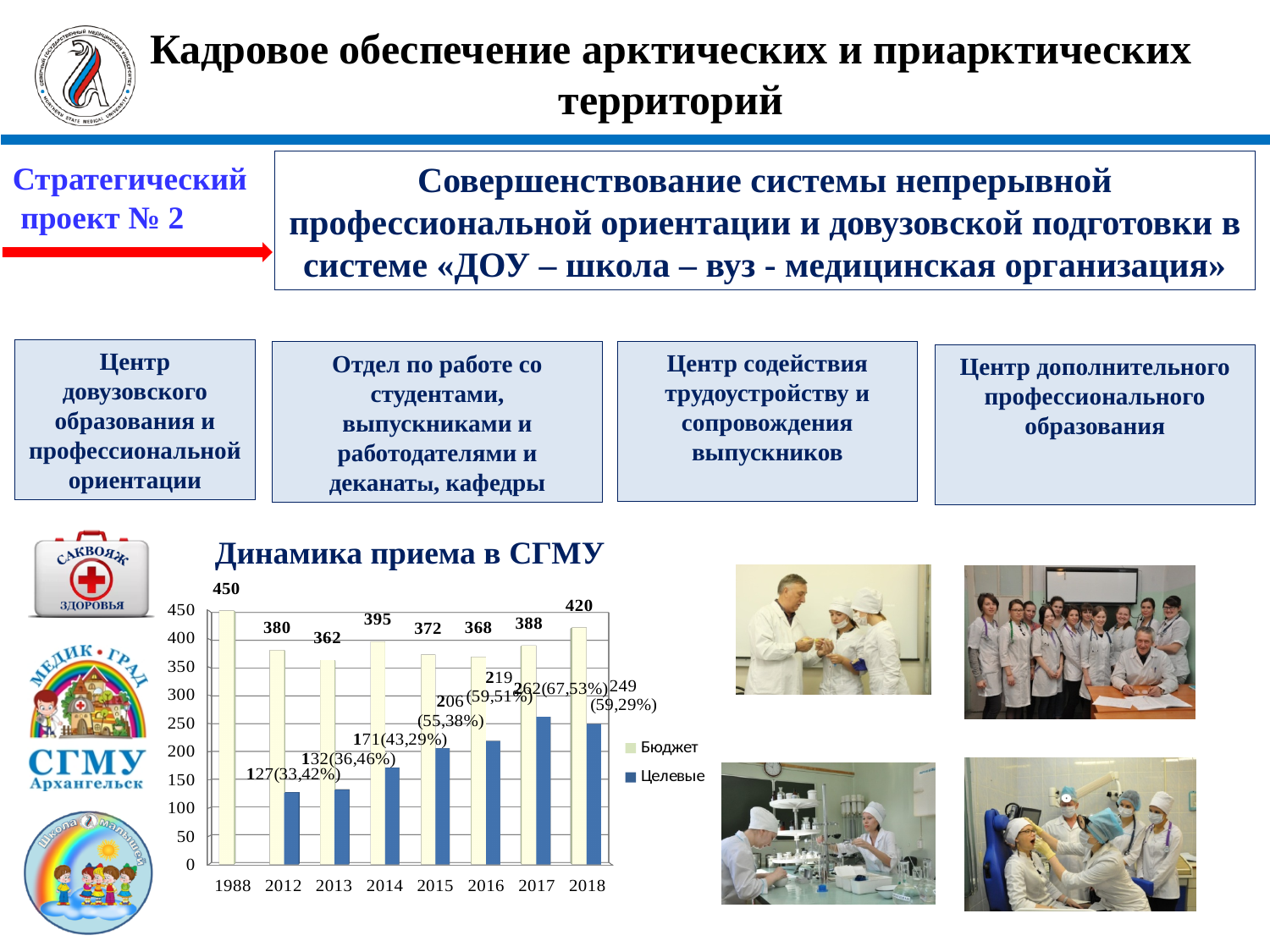
What is the Целевые value for 2012 in the chart 'Динамика приема в СГМУ'? 127(33,42%) Which year has the lowest Бюджет value in the chart 'Динамика приема в СГМУ'? 2013 Which year has the highest Бюджет value in the chart 'Динамика приема в СГМУ'? 1988 Which is larger in the chart 'Динамика приема в СГМУ': the Бюджет value for 2014 or for 2015? 2014 How many series does the legend of the chart 'Динамика приема в СГМУ' list? 2 What type of chart is 'Динамика приема в СГМУ'? Bar chart How many years are shown on the x axis of the chart 'Динамика приема в СГМУ'? 8 What is the Бюджет value for 2013 in the chart 'Динамика приема в СГМУ'? 362 Which year has the highest Целевые value in the chart 'Динамика приема в СГМУ'? 2017 What is the difference between the Бюджет values for 2018 and 2017 in the chart 'Динамика приема в СГМУ'? 32 What is the Бюджет value for 2018 in the chart 'Динамика приема в СГМУ'? 420 What is the Целевые value for 2017 in the chart 'Динамика приема в СГМУ'? 262(67,53%)